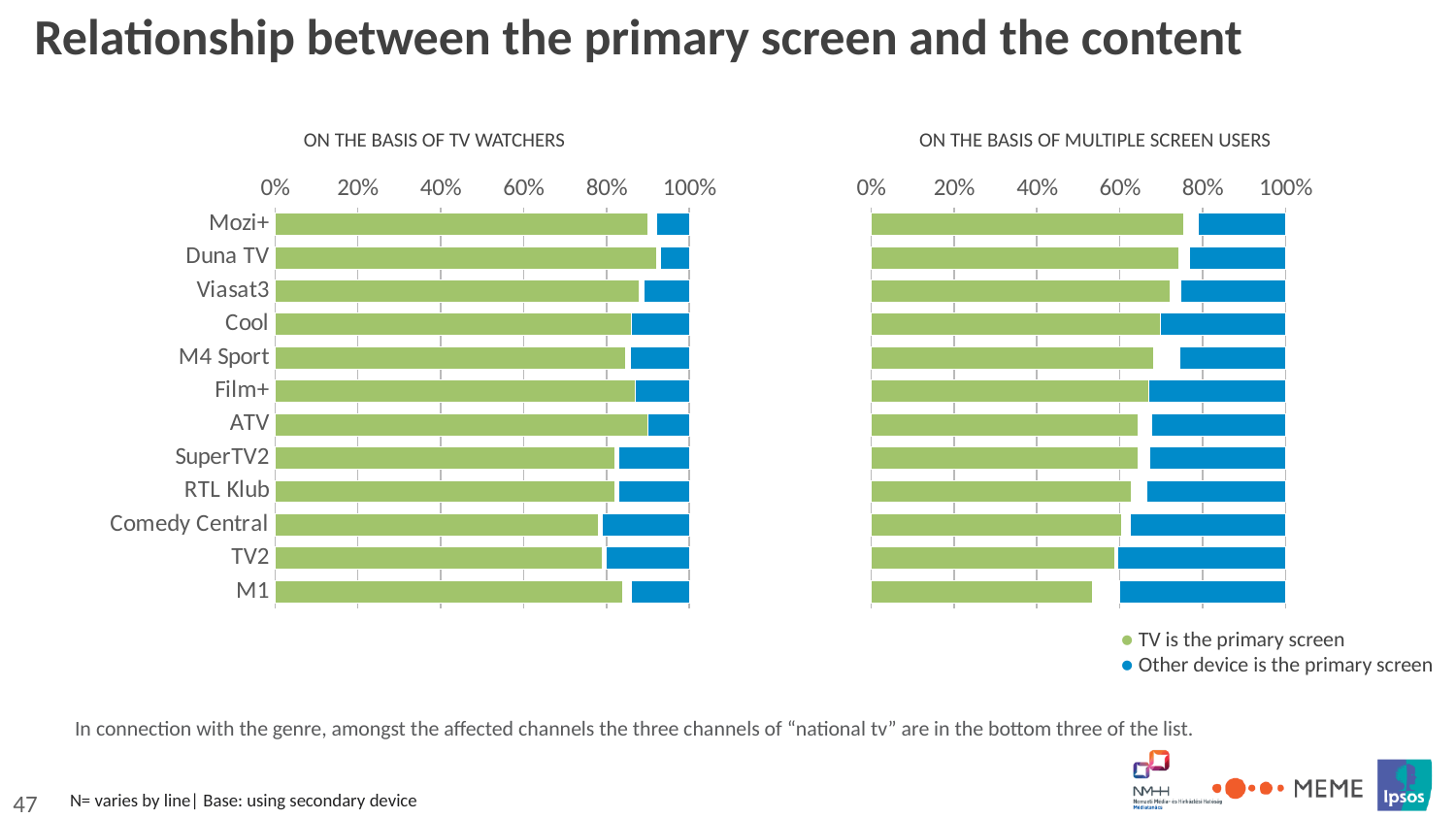
In the right chart (On the basis of multiple screen users), which channel has the lowest 'TV is the primary screen' share? M1 In the left chart (On the basis of TV watchers), which has the larger 'TV is the primary screen' share, Mozi+ or TV2? Mozi+ In the right chart (On the basis of multiple screen users), is the 'TV is the primary screen' value for M1 greater or less than 60%? less What kind of chart is used on this slide? Stacked bar chart Which colour represents 'Other device is the primary screen' in the legend? Blue In the left chart (On the basis of TV watchers), is the 'TV is the primary screen' value for Mozi+ greater or less than 80%? greater How many channels are listed in the left chart (On the basis of TV watchers)? 12 In the right chart (On the basis of multiple screen users), is the 'TV is the primary screen' value for Mozi+ greater or less than 80%? less How many series does the legend list? 2 In the right chart (On the basis of multiple screen users), do the 'TV is the primary screen' bars get longer or shorter going down the list from Mozi+ to M1? shorter In the right chart (On the basis of multiple screen users), which has the larger 'TV is the primary screen' share, Cool or M1? Cool